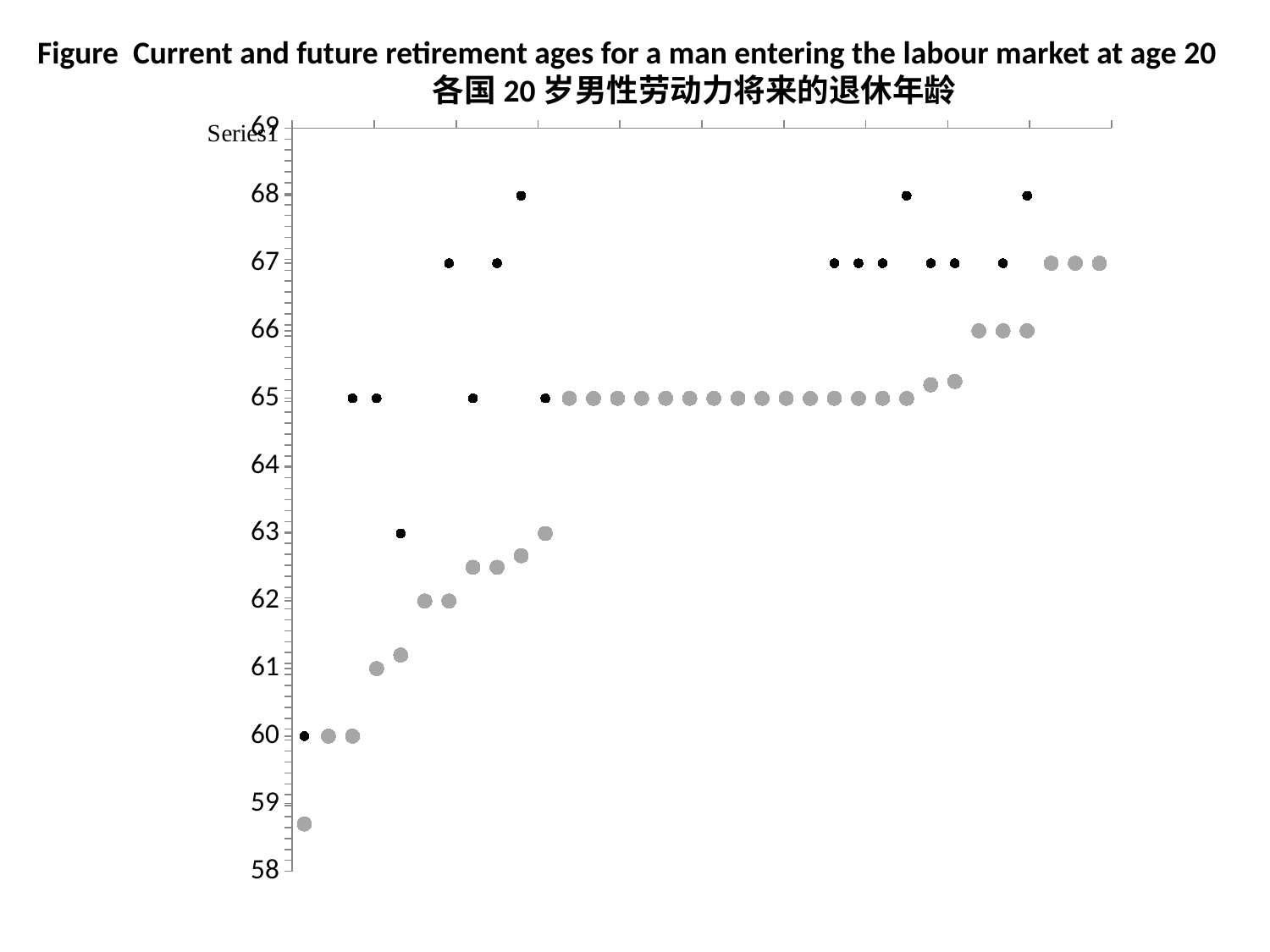
What is the highest value shown on the vertical axis? 69 Which reaches a higher value: the highest black point or the highest grey point? the highest black point What is the English title of the chart? Figure Current and future retirement ages for a man entering the labour market at age 20 Is the highest grey point greater or less than 68? less What is the highest value reached by any black point? 68 What kind of chart is shown on the slide? scatter chart Is the lowest grey point greater or less than 59? less Do the grey points rise or fall from left to right along the x axis? rise How many grey points sit at the value 66? 3 How many black points sit at the value 68? 3 How many grey points sit at the value 67? 3 What is the lowest value shown on the vertical axis? 58